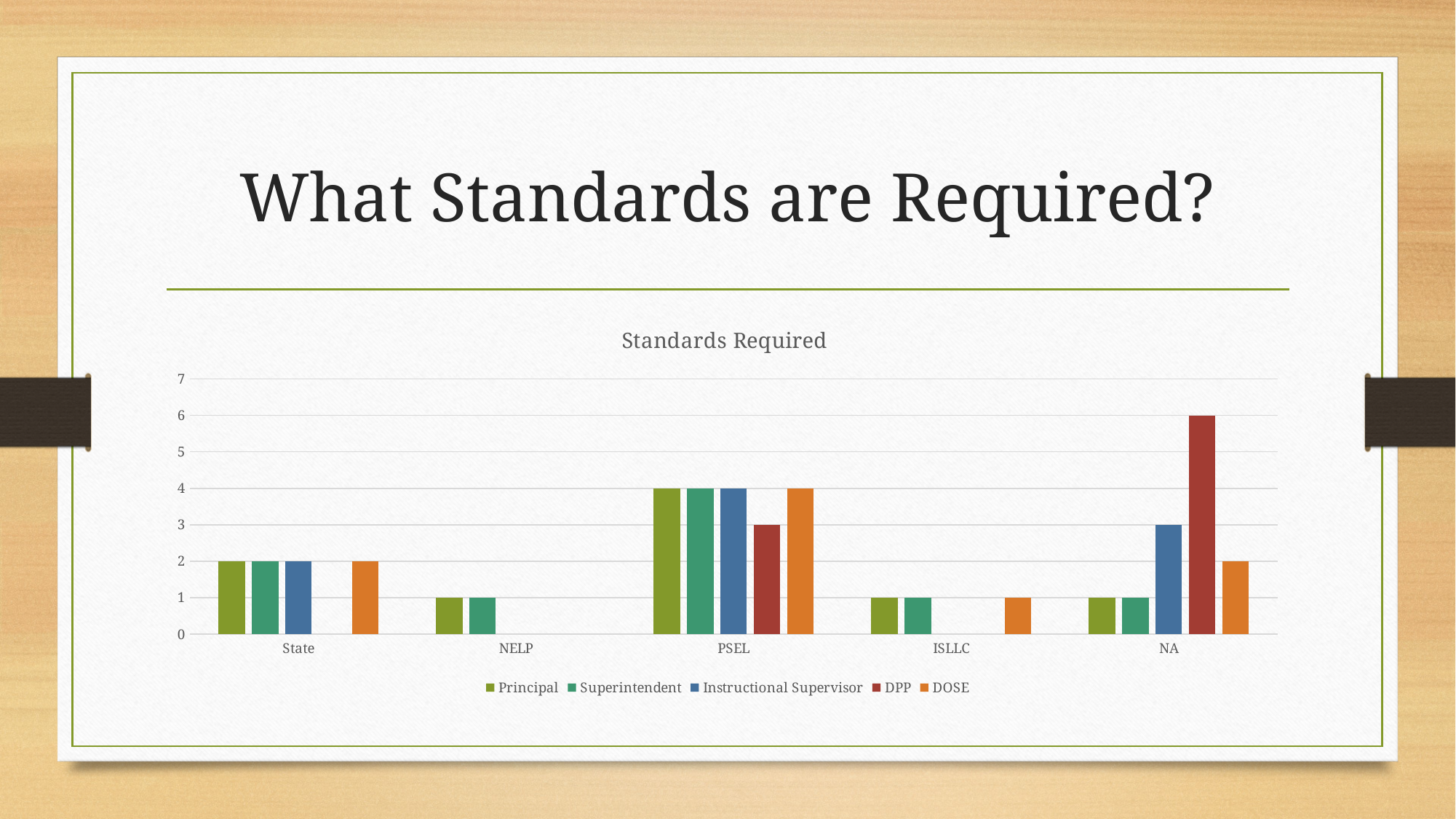
What is the value for Instructional Supervisor in the NA category? 3 How many series does the legend list? 5 What is the value for DPP in the PSEL category? 3 Which series has the lowest value in the PSEL category? DPP What is the difference between the DPP value for NA and the DPP value for PSEL? 3 What kind of chart is shown on the slide? bar chart Which series has the highest value in the NA category? DPP What is the title of the chart? Standards Required What is the value for DPP in the NA category? 6 Which is larger: the DOSE value for State or the DOSE value for ISLLC? State How many categories are shown on the x axis? 5 What is the value for Principal in the PSEL category? 4